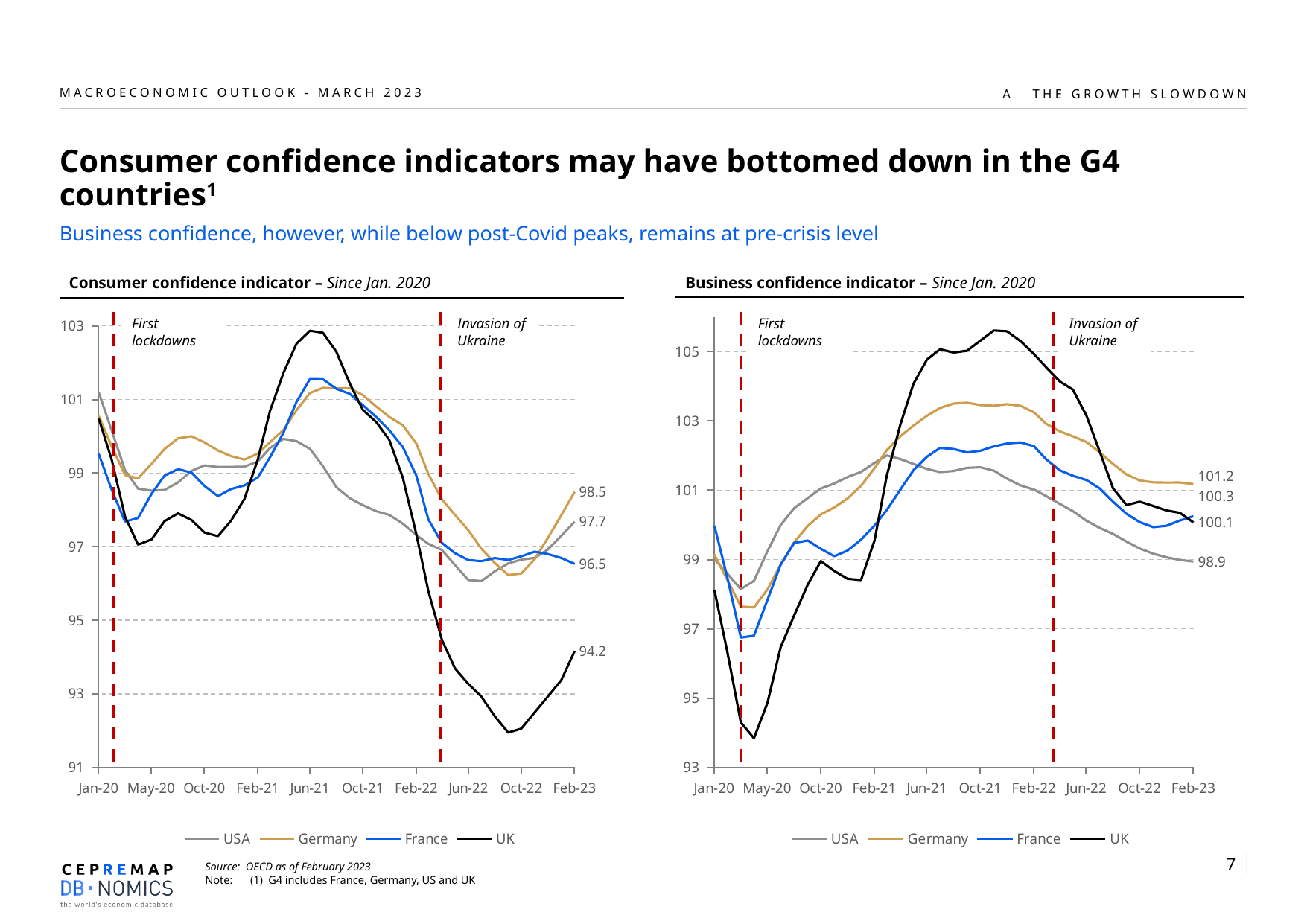
On the Business confidence indicator chart, is the peak value for the UK greater or less than 105? greater On the Consumer confidence indicator chart, what is the difference between the latest values for Germany and the UK? 4.3 On the Business confidence indicator chart, what is the difference between the latest values for Germany and the USA? 2.3 How many series does the legend of the Consumer confidence indicator chart list? 4 On the Consumer confidence indicator chart, what is the latest value shown for France? 96.5 On the Consumer confidence indicator chart, what is the latest value shown for Germany? 98.5 On the Business confidence indicator chart, what is the latest value shown for the USA? 98.9 On the Consumer confidence indicator chart, what is the latest value shown for the USA? 97.7 On the Consumer confidence indicator chart, which country has the lowest value at Feb-23? UK On the Business confidence indicator chart, what is the latest value shown for Germany? 101.2 What kind of chart is the Business confidence indicator chart? Line chart On the Consumer confidence indicator chart, what is the latest value shown for the UK? 94.2